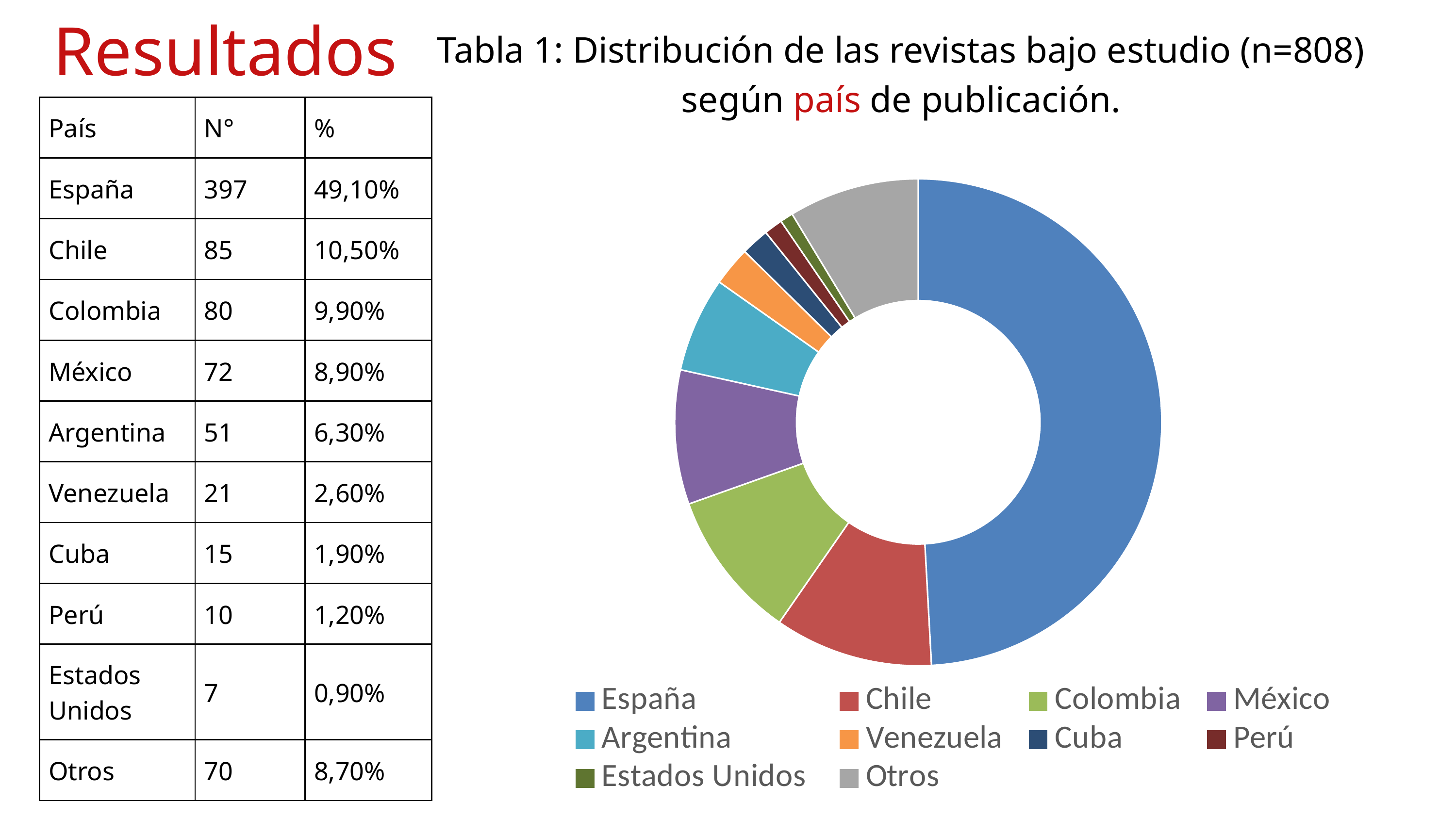
Which slice is larger, Argentina or Otros? Otros What percentage of the journals were published in España? 49,10% Which country has the smallest slice in the chart? Estados Unidos How many categories does the chart's legend list? 10 How many journals were published in Chile? 85 What is the difference in the number of journals between España and Chile? 312 What is the total number of journals represented in the chart (n)? 808 Which country has the largest slice in the chart? España What kind of chart is shown on the slide? Doughnut (pie) chart Which colour represents Otros in the chart? Grey What percentage of the journals were published in México? 8,90% Which slice is larger, Chile or Colombia? Chile